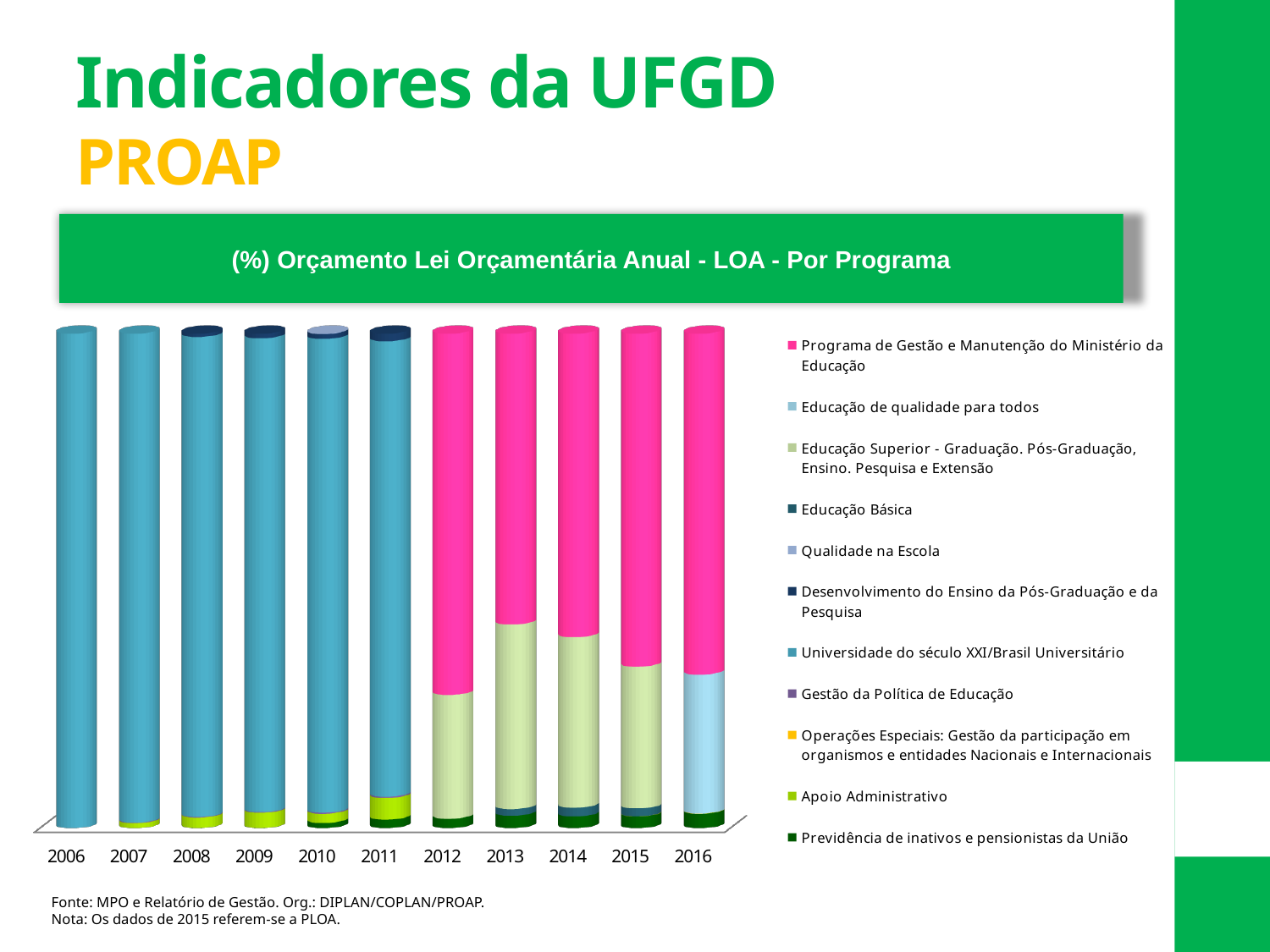
How many series does the chart's legend list? 11 What is the title of the chart? (%) Orçamento Lei Orçamentária Anual - LOA - Por Programa Among the years 2012 to 2015, which year has the smallest share for Educação Superior - Graduação. Pós-Graduação, Ensino. Pesquisa e Extensão? 2012 Which program accounts for the largest share of the 2006 bar? Universidade do século XXI/Brasil Universitário In 2016, which is larger: the share for Programa de Gestão e Manutenção do Ministério da Educação or the share for Educação de qualidade para todos? Programa de Gestão e Manutenção do Ministério da Educação Which program accounts for the largest share of the 2014 bar? Programa de Gestão e Manutenção do Ministério da Educação Which is the first year shown on the x axis of the chart? 2006 How many years are shown along the x axis of the chart? 11 In 2011, which is larger: the share for Universidade do século XXI/Brasil Universitário or the share for Apoio Administrativo? Universidade do século XXI/Brasil Universitário What kind of chart is shown on the slide? Stacked bar chart